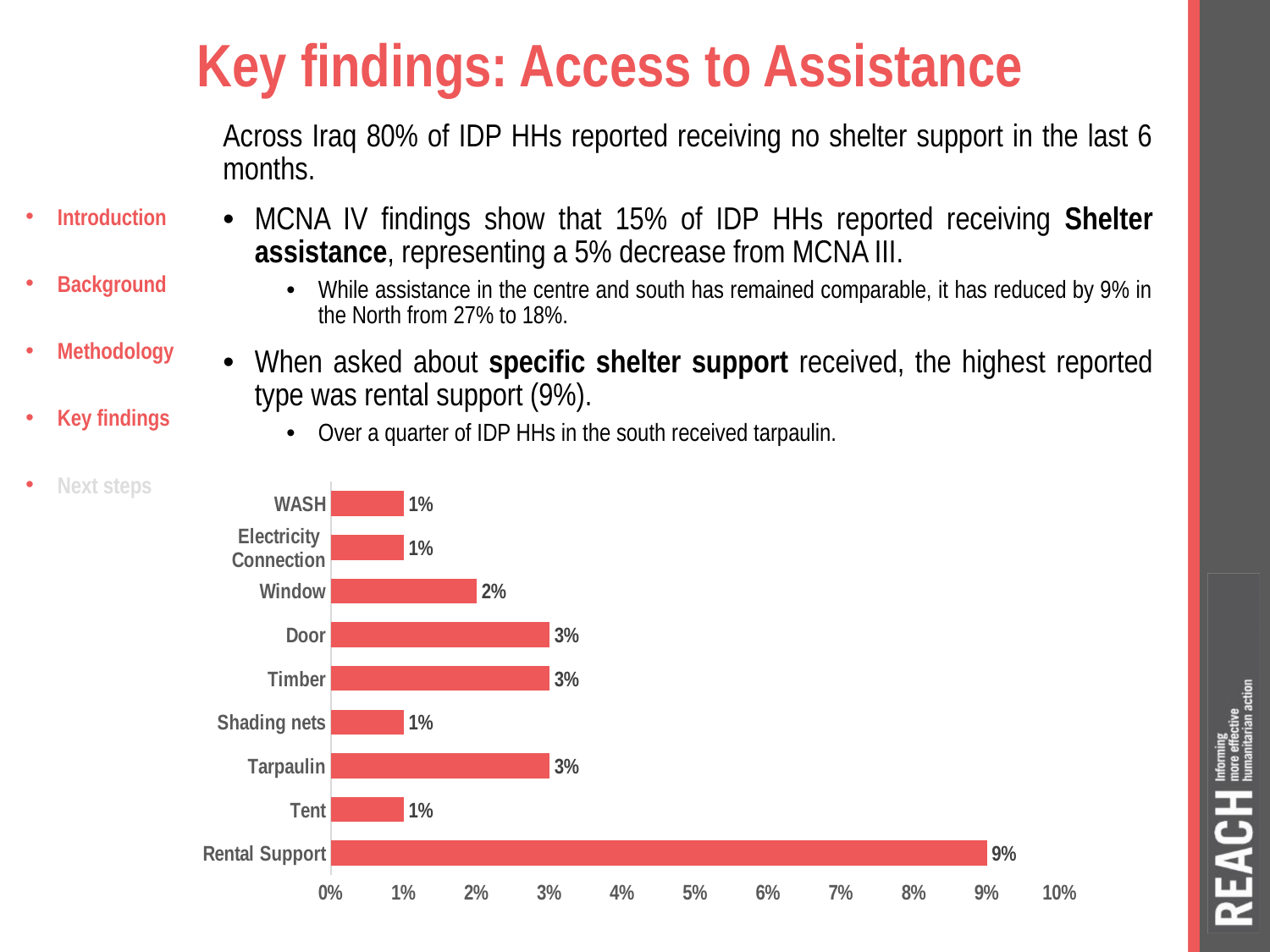
What is the difference between the values for Timber and Tent? 2% What is the value for Rental Support? 9% How many categories are shown in the chart? 9 Which is larger, the value for Window or the value for Shading nets? Window What is the maximum value shown on the x axis? 10% What is the value for Electricity Connection? 1% What kind of chart is shown on the slide? bar chart What is the value for Tarpaulin? 3% What is the difference between the values for Rental Support and Door? 6% Is the value for Rental Support greater or less than 5%? greater What is the value for Window? 2% Which category has the highest value? Rental Support